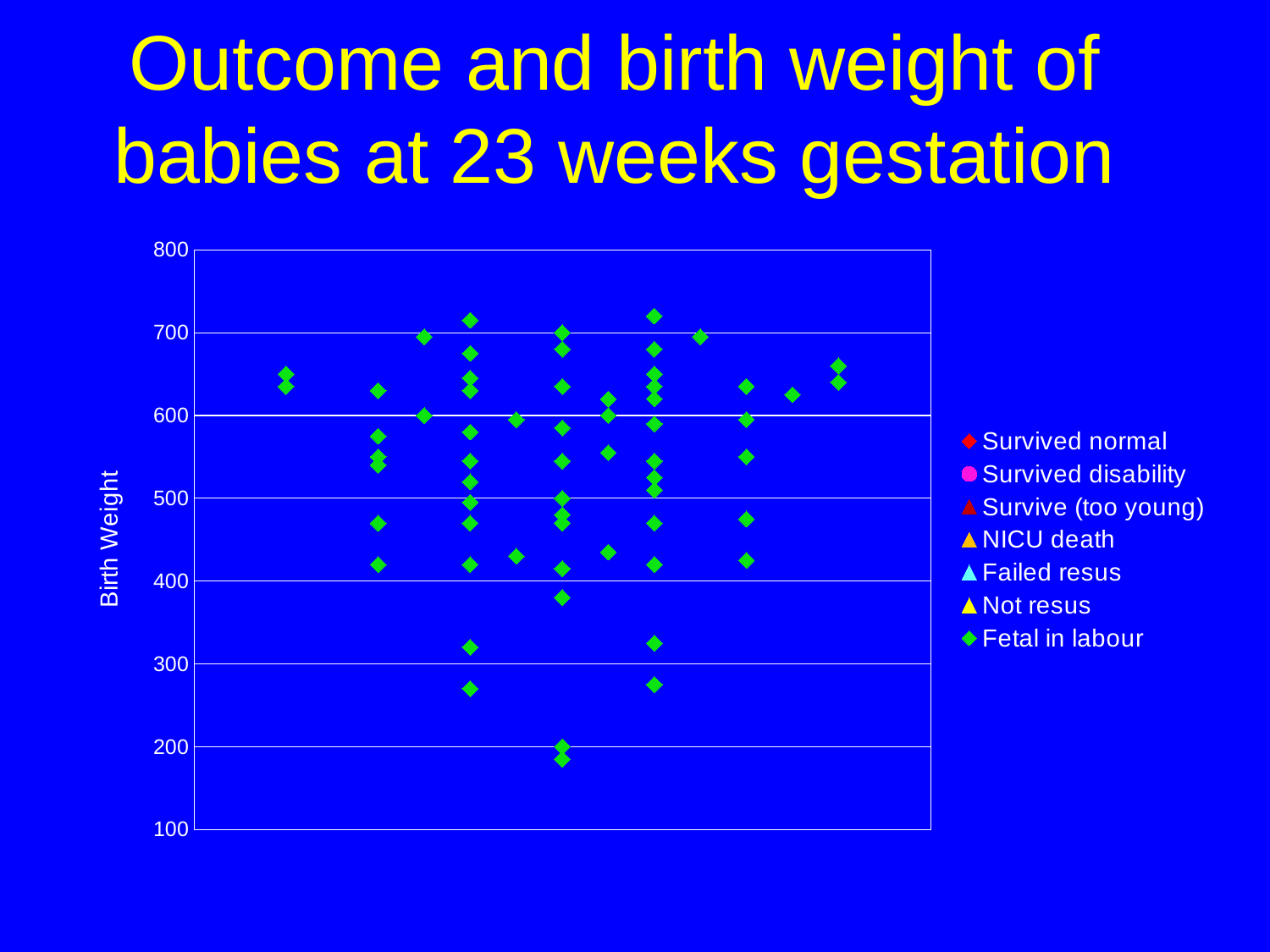
What is the title of the slide containing the chart? Outcome and birth weight of babies at 23 weeks gestation Is the lowest plotted birth weight greater or less than 300? less How many series does the legend list? 7 Is the lowest plotted birth weight greater or less than 200? less Which legend entry is represented by green diamonds? Fetal in labour What is the lowest value shown on the vertical axis? 100 Is the highest plotted birth weight greater or less than 800? less What kind of chart is shown on the slide? scatter chart What is the label on the vertical axis of the chart? Birth Weight What is the highest value shown on the vertical axis? 800